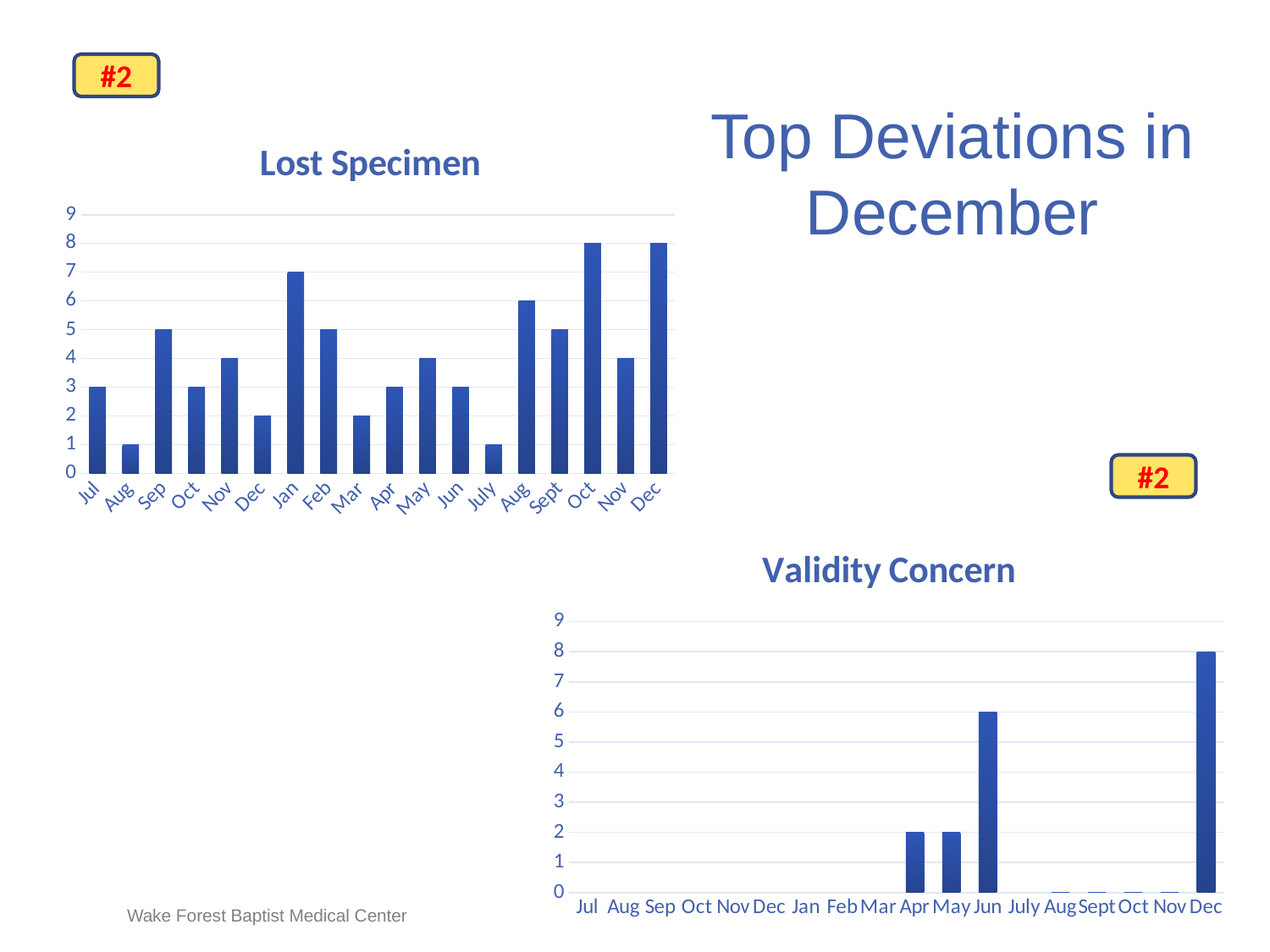
In the Lost Specimen chart, which is larger, the value for Jan or the value for May? Jan In the Validity Concern chart, what is the value for Apr? 2 In the Validity Concern chart, what is the difference between the values for Dec and Jun? 2 What kind of chart is the Lost Specimen chart? bar chart In the Lost Specimen chart, what is the value for Jan? 7 In the Lost Specimen chart, what is the difference between the values for Jan and Feb? 2 How many categories are shown on the x axis of the Lost Specimen chart? 18 In the Validity Concern chart, what is the value for Jun? 6 What is the title of the chart at the bottom right of the slide? Validity Concern In the Lost Specimen chart, is the value for the last Dec bar greater or less than 5? greater In the Validity Concern chart, which month has the highest value? Dec In the Lost Specimen chart, what is the value for Mar? 2